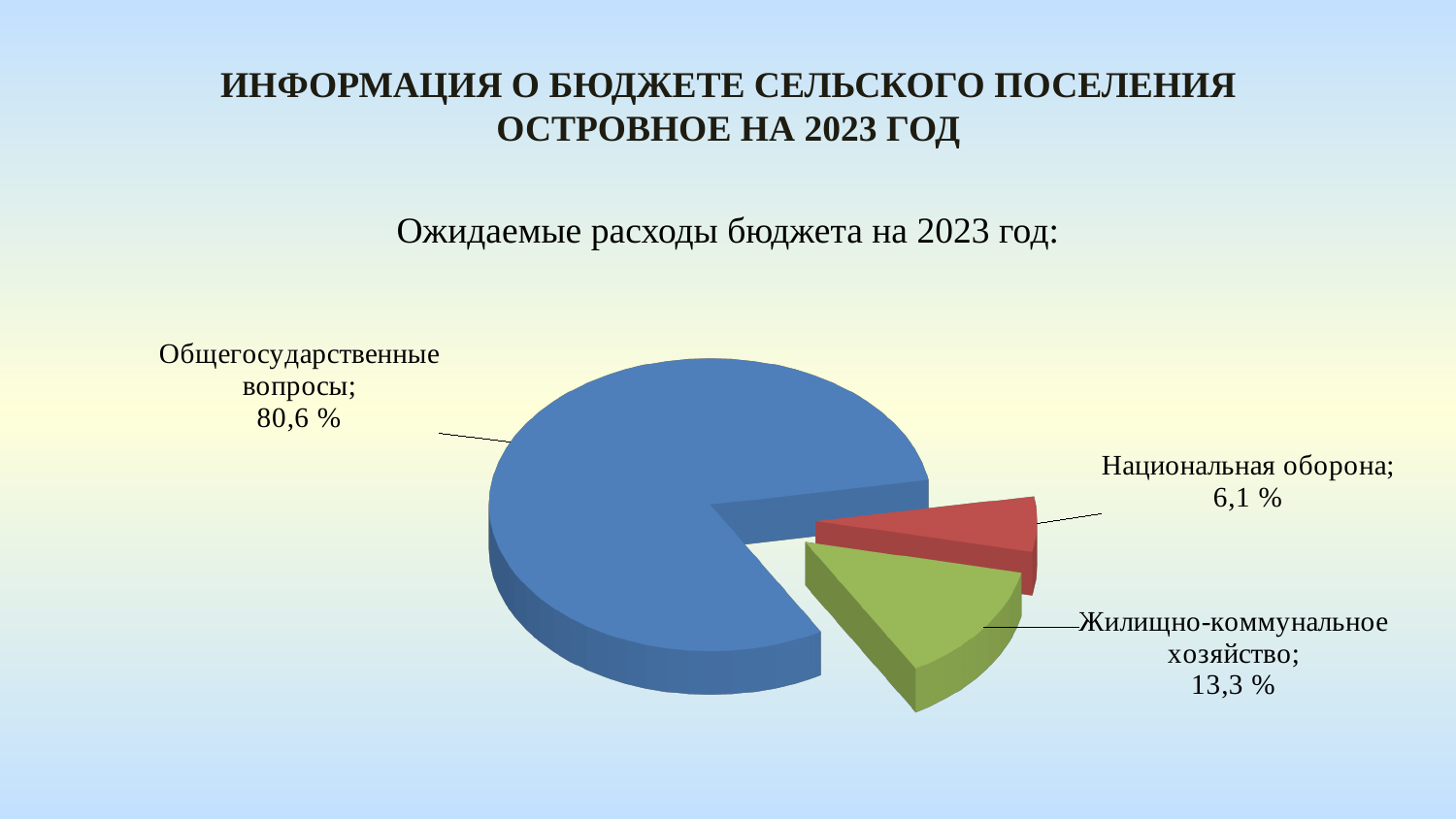
What kind of chart is shown on the slide? Pie chart What is the title of the chart? Ожидаемые расходы бюджета на 2023 год: Which category has the largest slice of the pie? Общегосударственные вопросы Which is larger: the share for Жилищно-коммунальное хозяйство or for Национальная оборона? Жилищно-коммунальное хозяйство Which category has the smallest slice of the pie? Национальная оборона What share of the pie does Жилищно-коммунальное хозяйство have? 13,3 % What is the difference in percentage points between Общегосударственные вопросы and Жилищно-коммунальное хозяйство? 67,3 What is the difference in percentage points between Жилищно-коммунальное хозяйство and Национальная оборона? 7,2 What share of the pie does Общегосударственные вопросы have? 80,6 % What share of the pie does Национальная оборона have? 6,1 % How many slices does the pie chart have? 3 What colour is the slice for Национальная оборона? Red